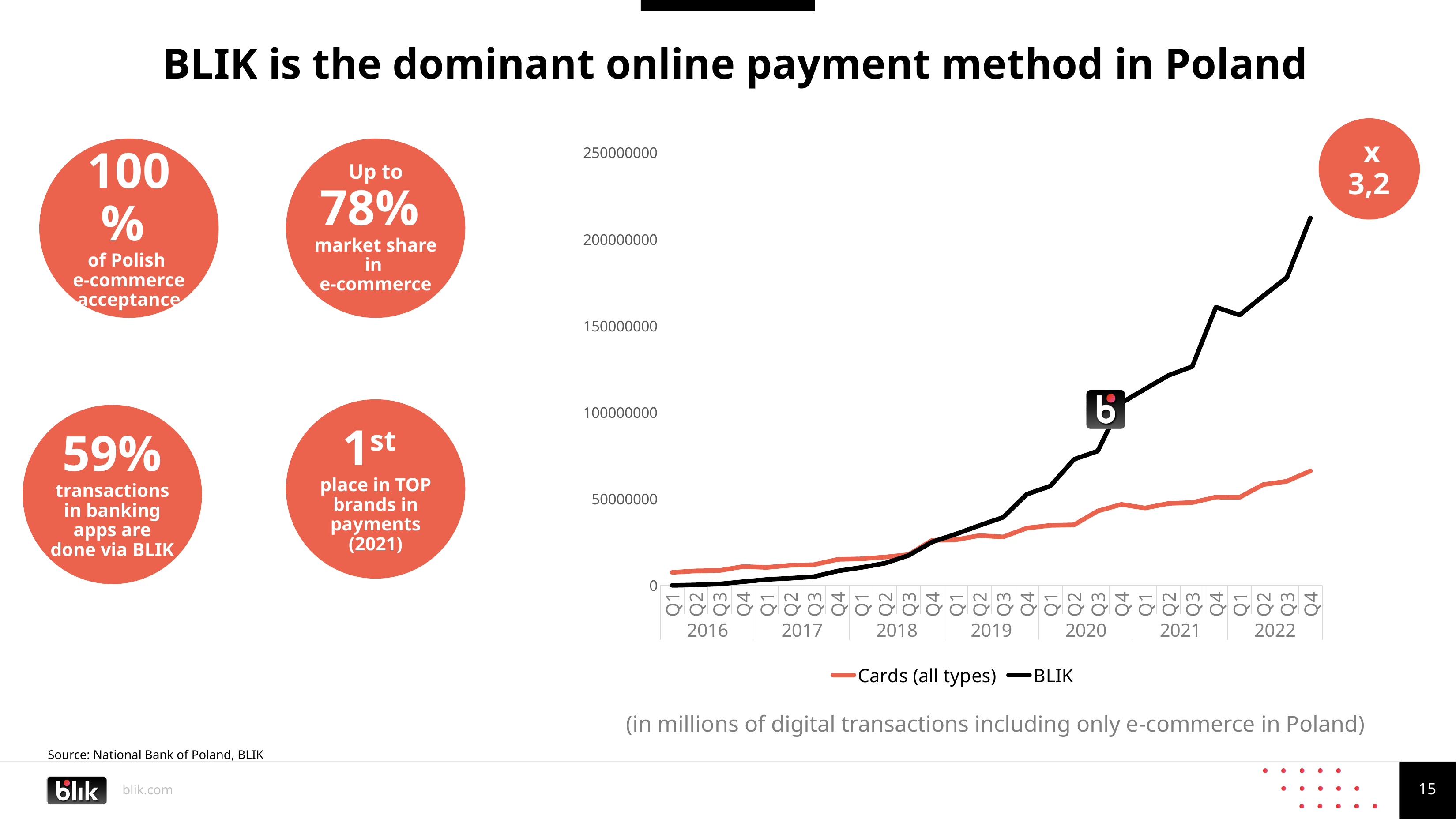
How many years are shown along the x axis of the chart? 7 Does the BLIK line rise or fall from Q1 2016 to Q4 2022? rise In Q4 2022, which series has the higher value, Cards (all types) or BLIK? BLIK Is the Cards (all types) value for Q4 2022 greater or less than 100000000? less How many series does the chart legend list? 2 How many quarterly data points does each series have on the chart? 28 What kind of chart is shown on the slide? line chart Is the BLIK value for Q4 2022 greater or less than 200000000? greater In Q1 2016, which series has the higher value, Cards (all types) or BLIK? Cards (all types) Which colour is used for the BLIK line in the chart? black What are the two series named in the chart legend? Cards (all types) and BLIK